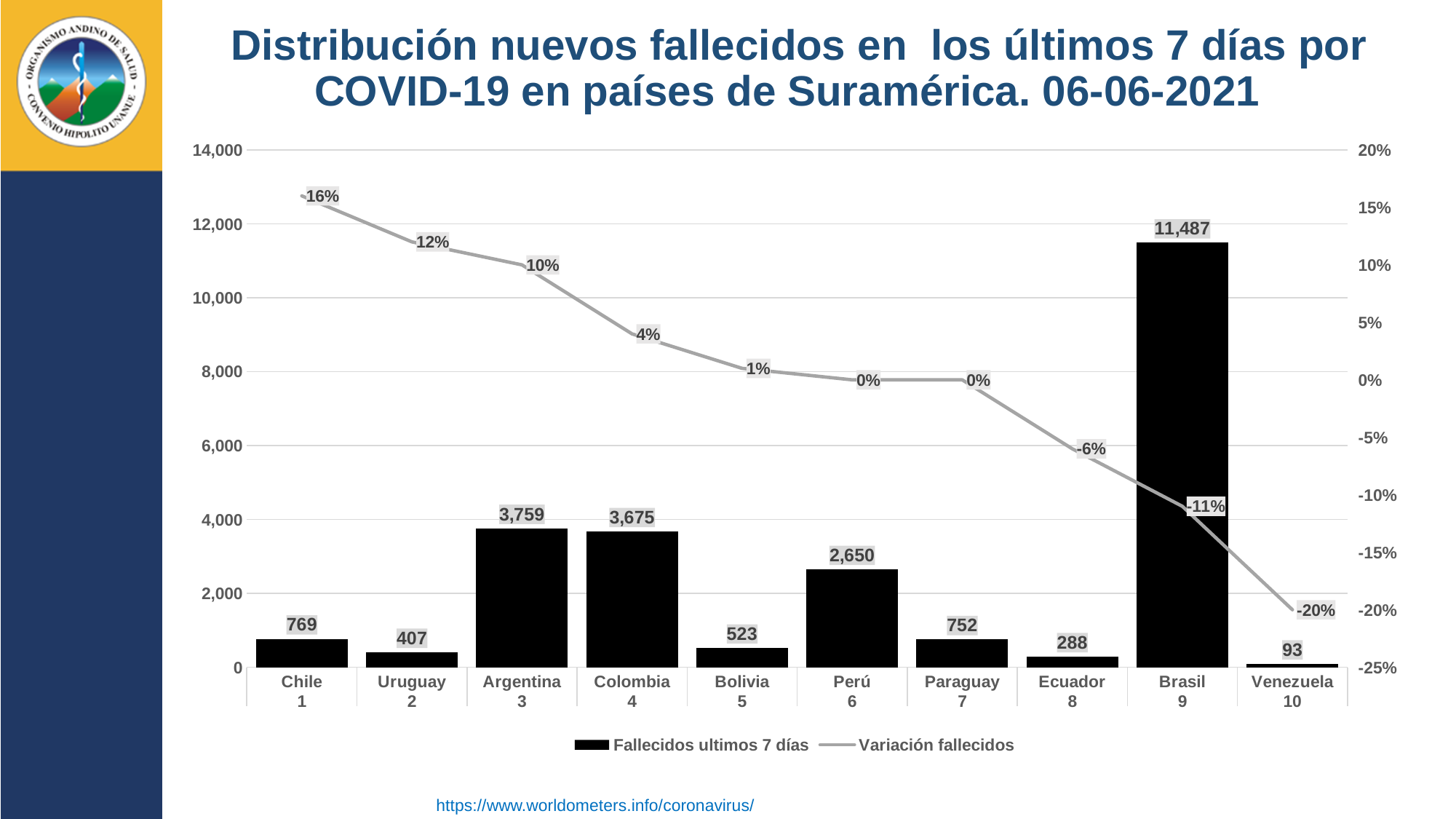
Which country has the lowest number of 'Fallecidos ultimos 7 días'? Venezuela What kind of chart is used for the 'Fallecidos ultimos 7 días' series? Bar chart Does the 'Variación fallecidos' line rise or fall from Chile to Venezuela? Fall What is the value of 'Fallecidos ultimos 7 días' for Perú? 2,650 What is the difference in 'Fallecidos ultimos 7 días' between Argentina and Colombia? 84 What is the value of 'Fallecidos ultimos 7 días' for Brasil? 11,487 Which country has the highest number of 'Fallecidos ultimos 7 días'? Brasil How many series does the legend list? 2 How many countries are shown on the x axis? 10 What is the 'Variación fallecidos' value for Chile? 16% Which has more 'Fallecidos ultimos 7 días', Chile or Paraguay? Chile What is the 'Variación fallecidos' value for Venezuela? -20%